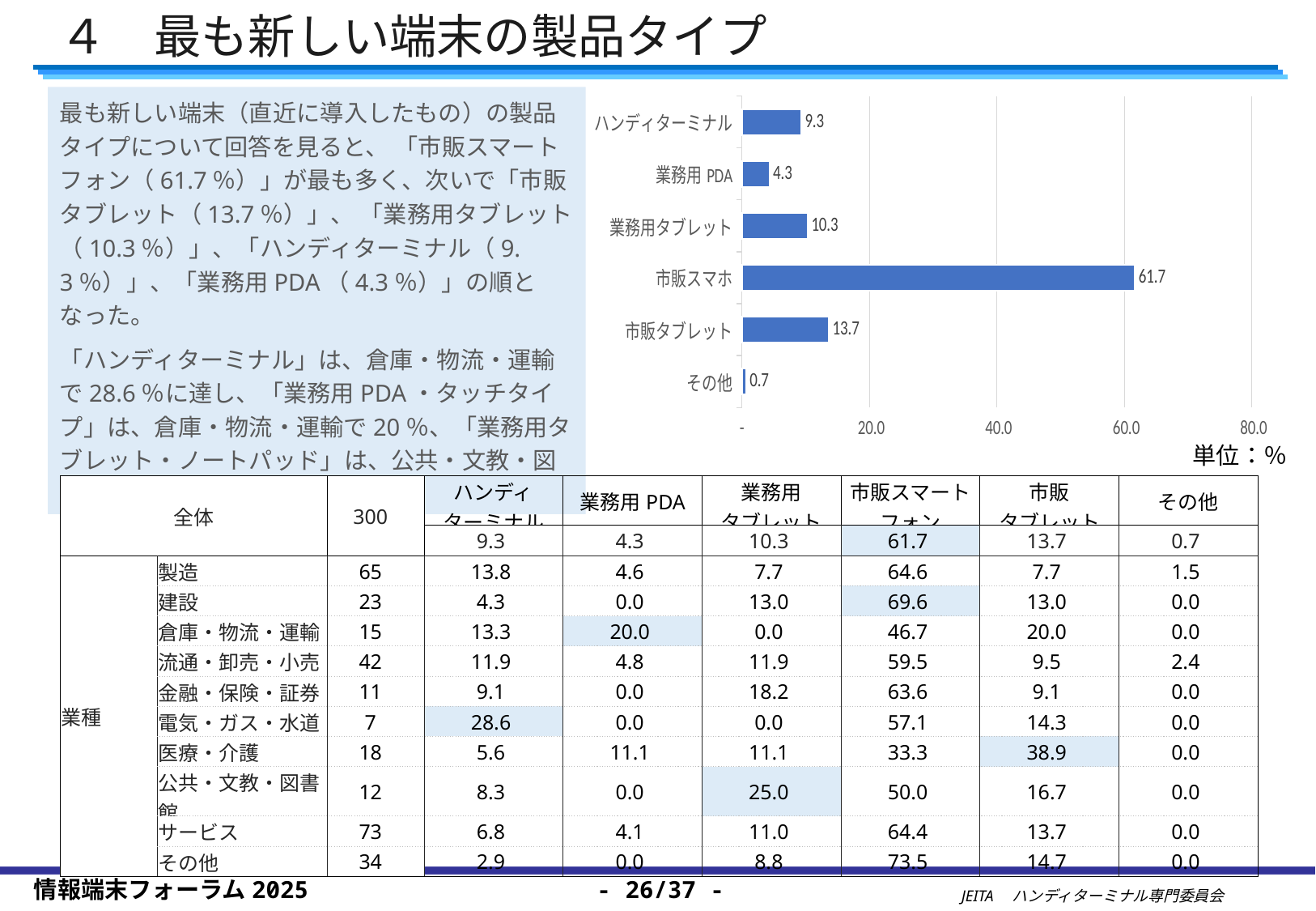
Which category has the highest value in the bar chart? 市販スマホ Which is larger in the bar chart, 業務用タブレット or ハンディターミナル? 業務用タブレット Which category has the lowest value in the bar chart? その他 What unit is indicated for the values in the bar chart? % What is the value for 市販スマホ in the bar chart? 61.7 What type of chart is shown on the slide? bar chart How many categories are shown in the bar chart? 6 Is the value for 市販スマホ greater or less than 60.0? greater What is the value for 業務用PDA in the bar chart? 4.3 What is the value for 市販タブレット in the bar chart? 13.7 What is the difference between the values for 市販タブレット and 業務用タブレット in the bar chart? 3.4 What is the value for ハンディターミナル in the bar chart? 9.3